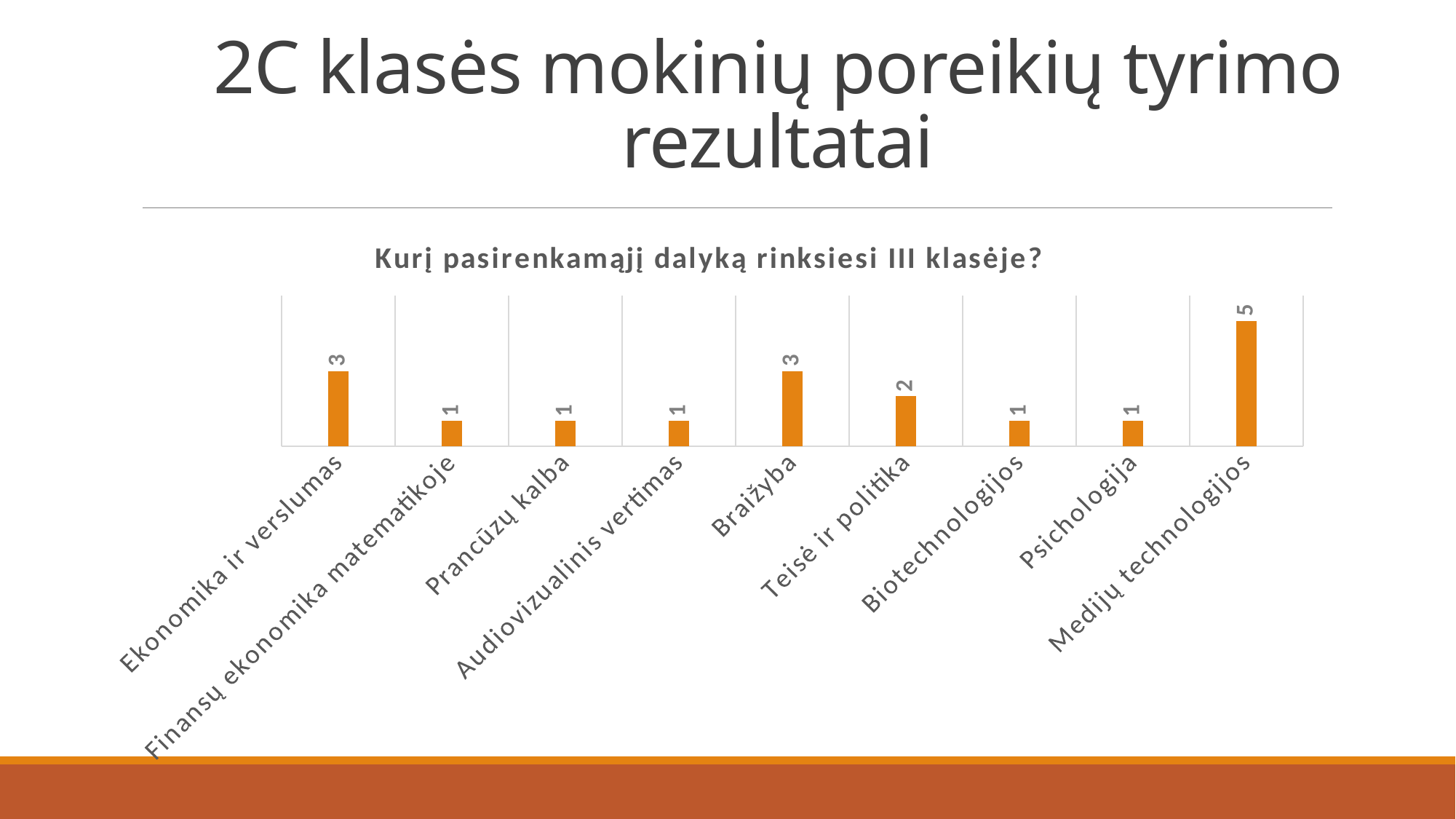
What is the difference between the values for Teisė ir politika and Biotechnologijos? 1 What is the title of the chart? Kurį pasirenkamąjį dalyką rinksiesi III klasėje? What kind of chart is shown on the slide? Bar chart What is the difference between the values for Medijų technologijos and Braižyba? 2 What is the value for Medijų technologijos? 5 Which category has the highest value? Medijų technologijos How many categories have a value of 1? 5 Which is larger, the value for Braižyba or the value for Teisė ir politika? Braižyba What is the value for Psichologija? 1 What is the value for Ekonomika ir verslumas? 3 How many categories are shown on the x axis? 9 What is the value for Teisė ir politika? 2